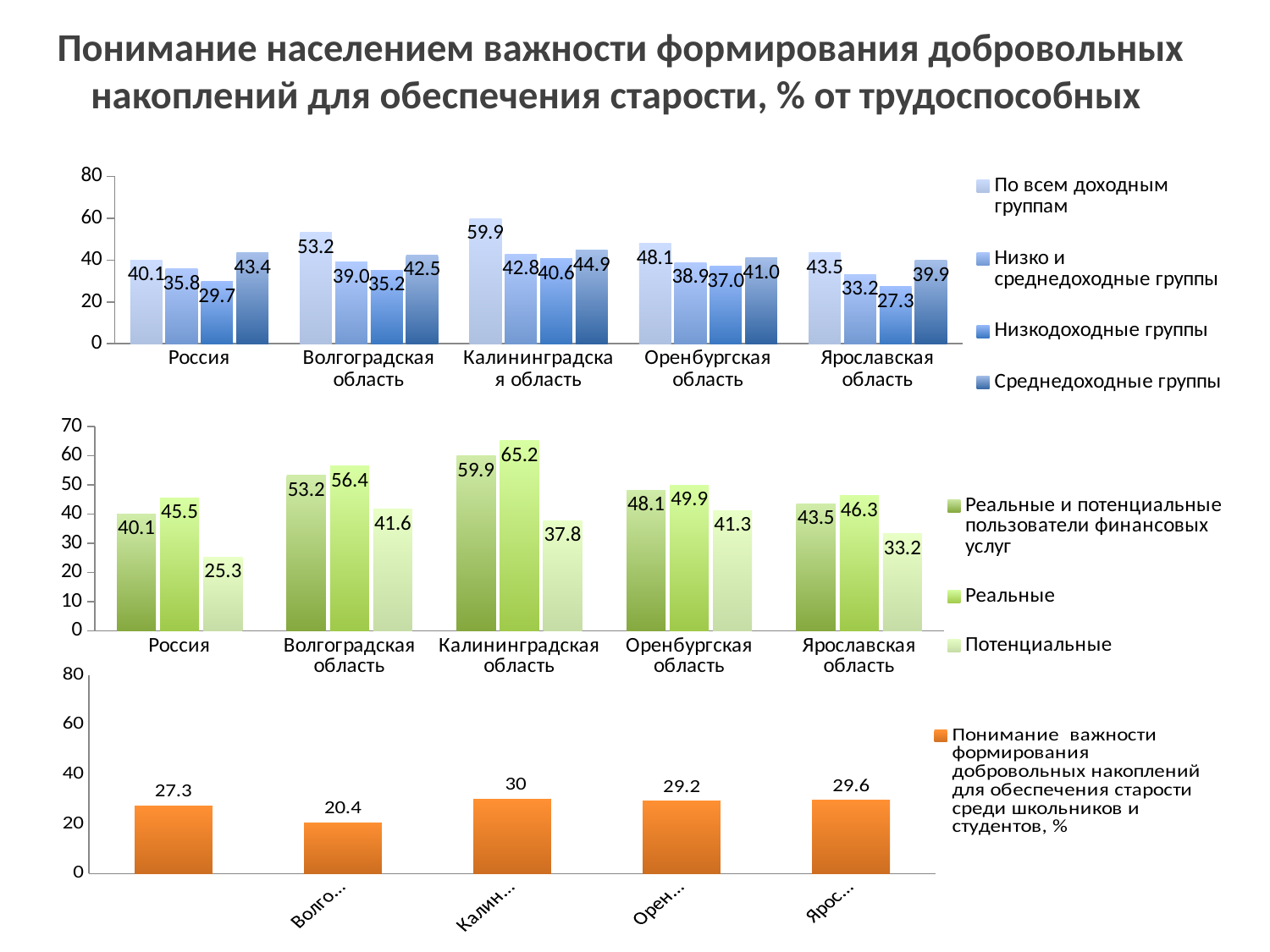
In the middle chart, which is larger for Оренбургская область: 'Реальные' or 'Потенциальные'? Реальные In the top chart, which category has the lowest value in the series 'Низко и среднедоходные группы'? Ярославская область In the top chart, what is the value for Калининградская область in the series 'По всем доходным группам'? 59.9 What kind of chart is the bottom chart? Bar chart In the bottom chart, what is the highest value shown? 30 In the bottom chart, what is the lowest value shown? 20.4 In the top chart, what is the value for Ярославская область in the series 'Низкодоходные группы'? 27.3 In the middle chart, what is the value for Калининградская область in the series 'Реальные'? 65.2 In the top chart, how many series does the legend list? 4 In the top chart, what is the difference between the 'Среднедоходные группы' and 'Низкодоходные группы' values for Россия? 13.7 In the middle chart, how many categories are shown on the x axis? 5 In the middle chart, which category has the lowest value in the series 'Потенциальные'? Россия